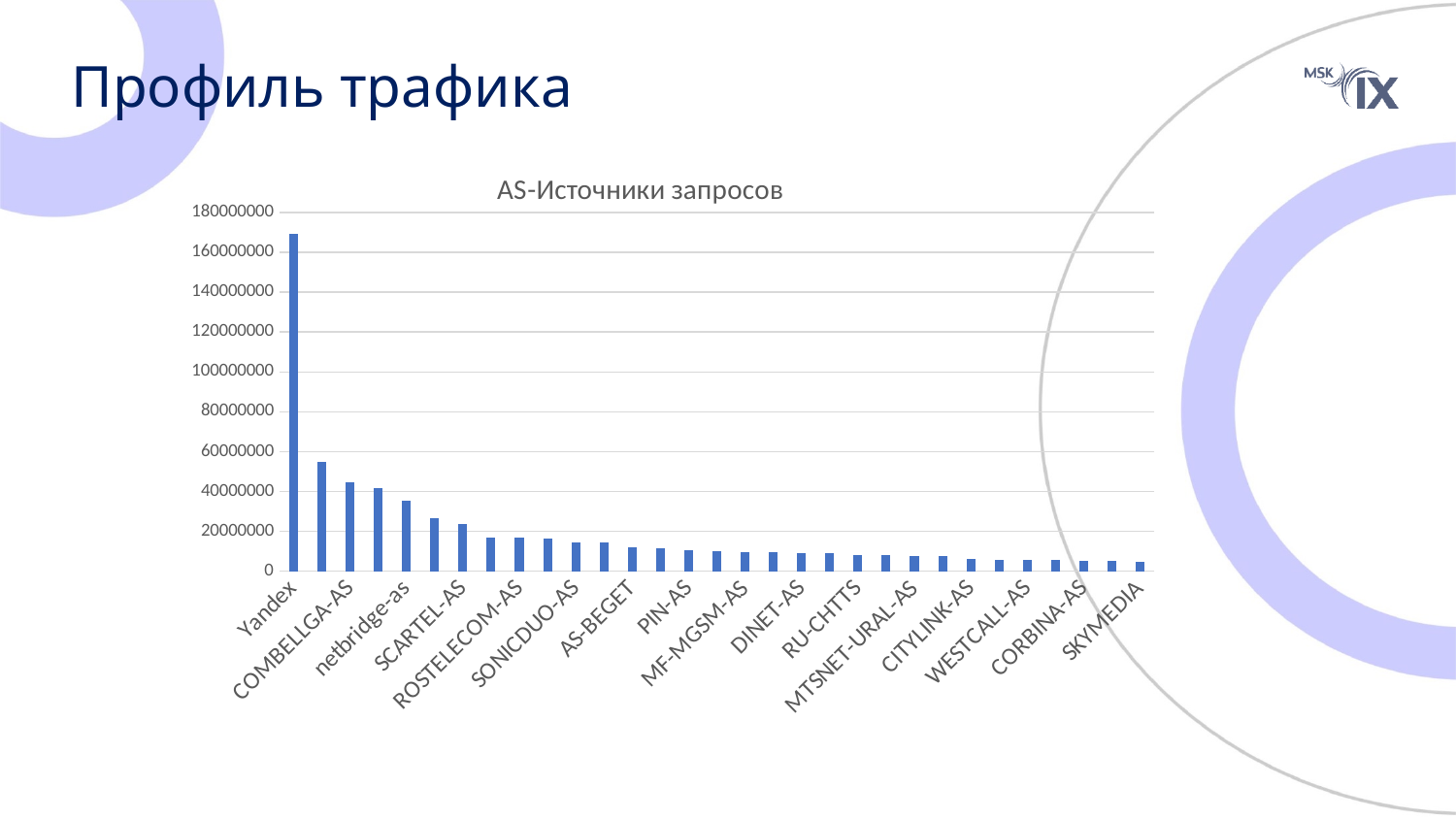
Which is larger, the value for Yandex or the value for COMBELLGA-AS? Yandex Is the value for SKYMEDIA greater or less than 20000000? less What kind of chart is shown on the slide? bar chart Is the value for COMBELLGA-AS greater or less than 60000000? less Which is larger, the value for netbridge-as or the value for SCARTEL-AS? netbridge-as Is the value for Yandex greater or less than 140000000? greater Do the values rise or fall from left to right along the x axis? fall Which category has the highest value in the chart? Yandex What is the title of the chart? AS-Источники запросов